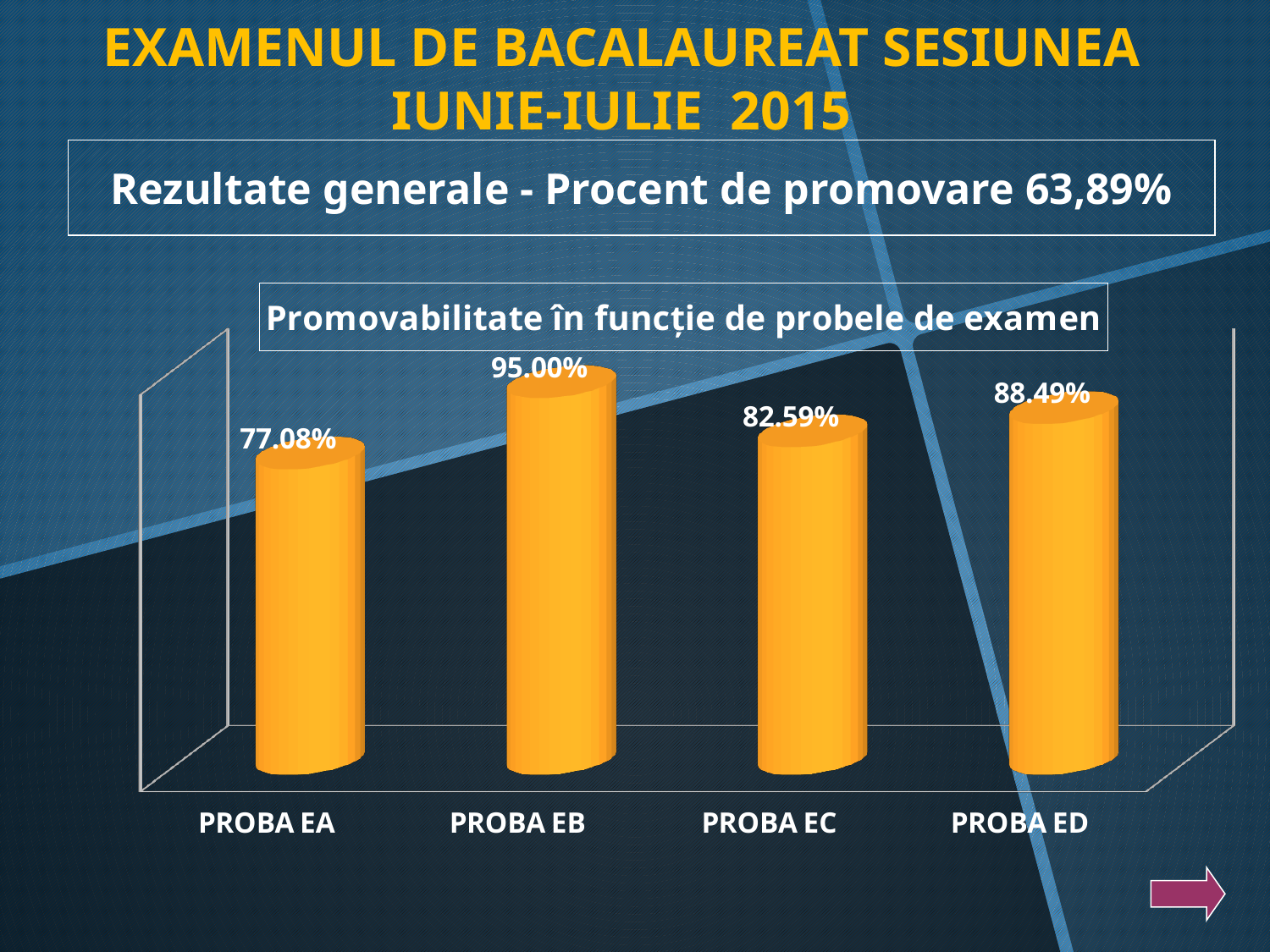
What is the difference between the values for PROBA ED and PROBA EC? 5.90% Which is larger, the value for PROBA EC or the value for PROBA ED? PROBA ED Which category has the highest value? PROBA EB What is the value for PROBA ED? 88.49% What kind of chart is shown on the slide? bar chart What is the value for PROBA EB? 95.00% How many categories are shown in the chart? 4 What is the value for PROBA EC? 82.59% What is the title of the chart? Promovabilitate în funcție de probele de examen What is the difference between the values for PROBA EB and PROBA EA? 17.92% What is the value for PROBA EA? 77.08% Which category has the lowest value? PROBA EA